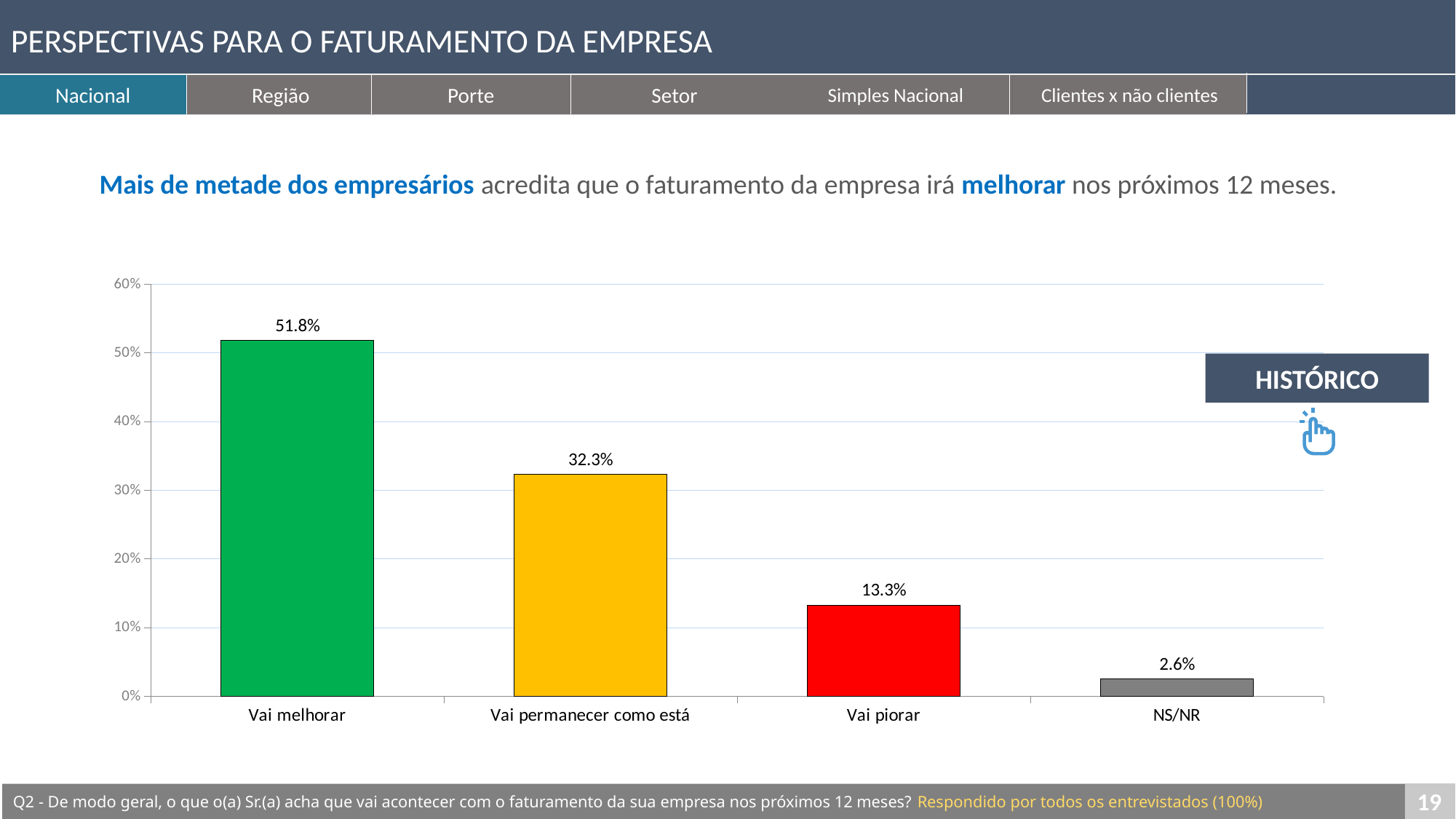
What is the difference between the values for "Vai piorar" and "NS/NR"? 10.7% Which category has the lowest value? NS/NR How many categories are shown on the chart? 4 What is the value for "NS/NR"? 2.6% What colour is the bar for "Vai piorar"? Red What is the value for "Vai melhorar"? 51.8% What is the value for "Vai permanecer como está"? 32.3% What is the value for "Vai piorar"? 13.3% What is the difference between the values for "Vai melhorar" and "Vai permanecer como está"? 19.5% Which category has the highest value? Vai melhorar What kind of chart is shown on the slide? Bar chart Which is larger, the value for "Vai permanecer como está" or the value for "Vai piorar"? Vai permanecer como está